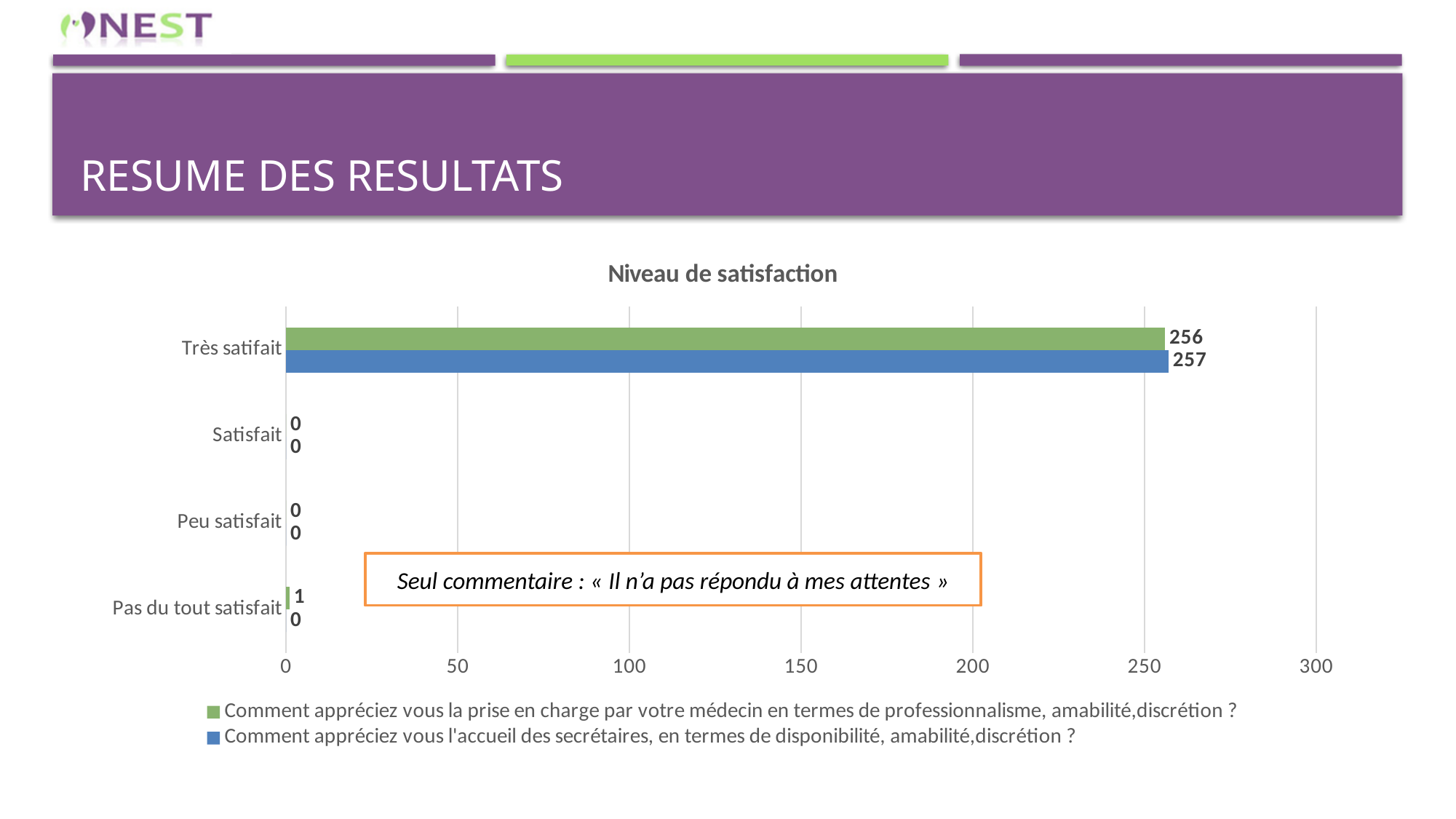
What is the value for 'Satisfait' in the series about the secrétaires? 0 How many categories are shown on the vertical axis of the chart? 4 How many series does the legend list? 2 Which colour represents the series about the accueil des secrétaires? blue What kind of chart is shown on the slide? bar chart What is the difference between the 'Très satifait' values of the secrétaires series and the médecin series? 1 What is the title of the chart? Niveau de satisfaction What is the value for 'Très satifait' in the series about the médecin (prise en charge par votre médecin)? 256 What is the value for 'Pas du tout satisfait' in the series about the médecin? 1 Is the value for 'Très satifait' in the médecin series greater or less than 250? greater Which category has the highest value in the series about the secrétaires? Très satifait What is the value for 'Très satifait' in the series about the secrétaires (accueil des secrétaires)? 257